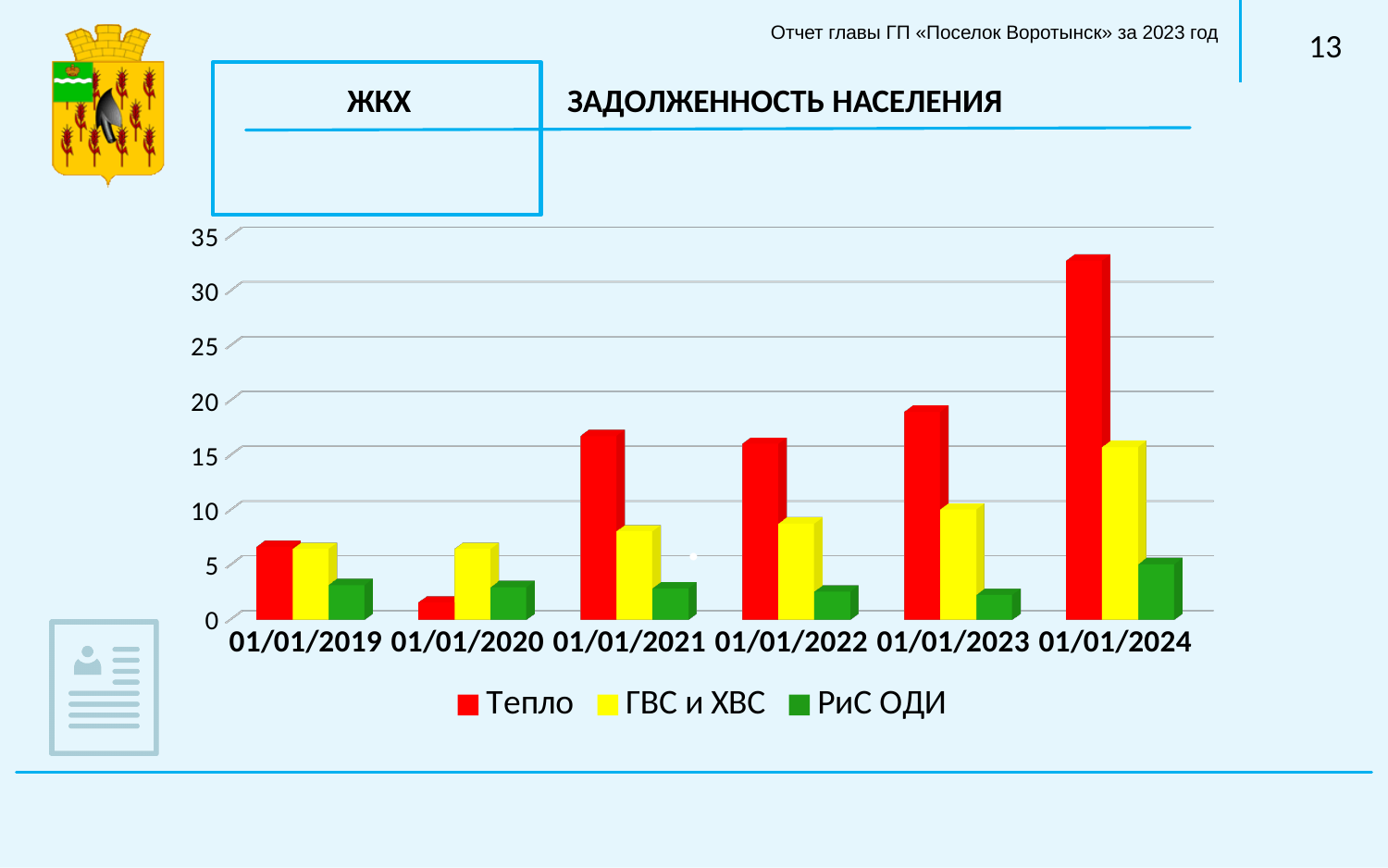
Does the value for ГВС и ХВС rise or fall from 01/01/2020 to 01/01/2024? rise On which date is the value for Тепло lowest? 01/01/2020 What kind of chart is shown on the slide? bar chart Is the value for Тепло on 01/01/2024 greater or less than 30? greater On which date is the value for Тепло highest? 01/01/2024 How many series does the legend list? 3 What is the title of the chart? ЗАДОЛЖЕННОСТЬ НАСЕЛЕНИЯ How many dates are shown along the x axis? 6 On 01/01/2024, which is larger: Тепло or ГВС и ХВС? Тепло Is the value for ГВС и ХВС on 01/01/2024 greater or less than 20? less On which date is the value for ГВС и ХВС highest? 01/01/2024 Is the value for Тепло on 01/01/2020 greater or less than 5? less